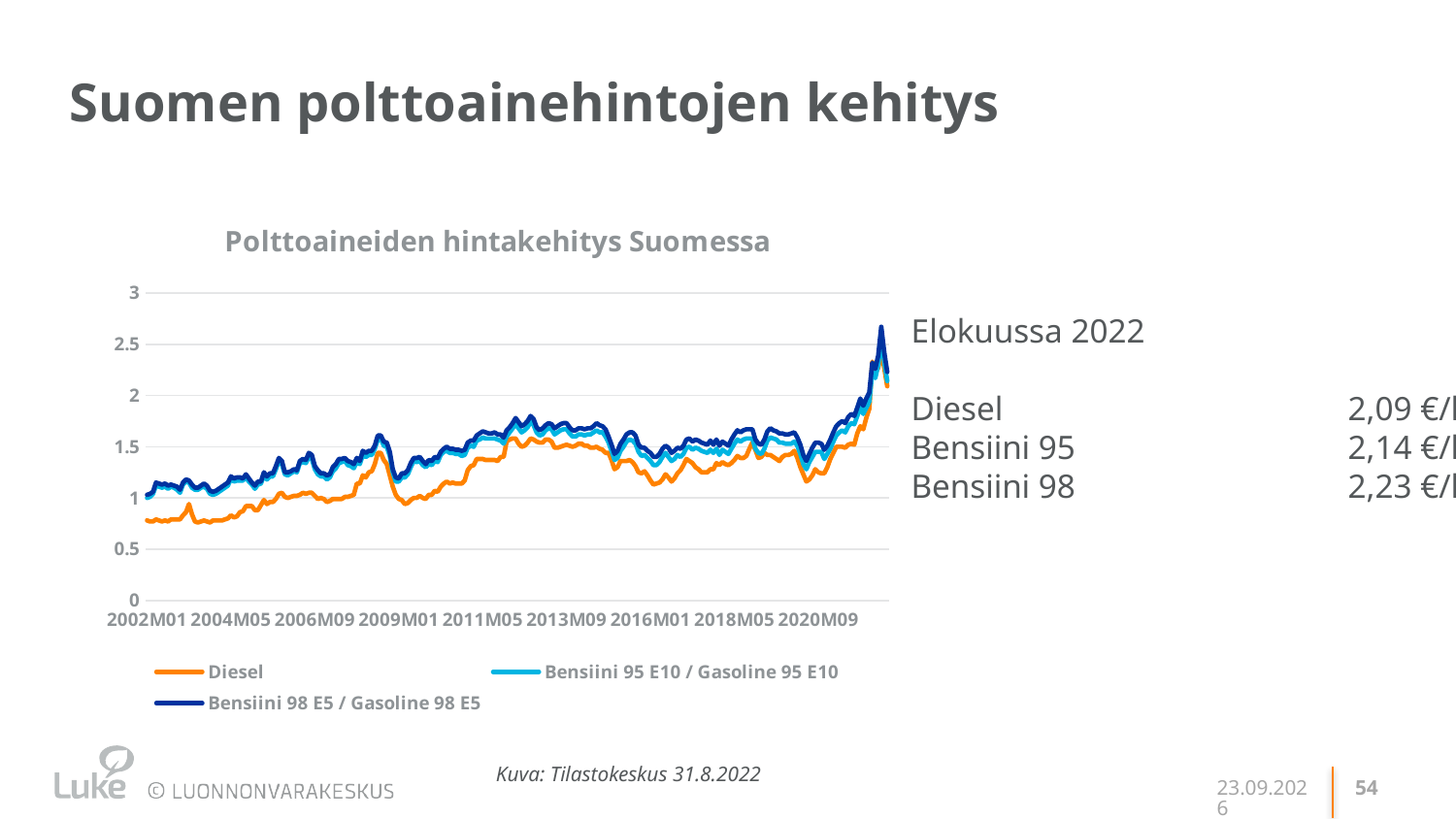
According to the slide, what was the Diesel price in August 2022 (Elokuussa 2022)? 2,09 €/l What is the title of the chart? Polttoaineiden hintakehitys Suomessa Which series reaches the highest value on the chart? Bensiini 98 E5 / Gasoline 98 E5 Overall, do fuel prices rise or fall from 2002M01 to the end of the series? rise Is the Diesel value at 2002M01 greater or less than 1? less In August 2022, which was higher: the Bensiini 95 price or the Diesel price? Bensiini 95 What is the difference between the Bensiini 98 and Diesel prices in August 2022 as given on the slide? 0,14 €/l According to the slide, what was the Bensiini 98 price in August 2022? 2,23 €/l What kind of chart is shown on the slide? line chart Is the peak value of Bensiini 98 E5 / Gasoline 98 E5 at the end of the series greater or less than 2.5? greater How many series does the chart's legend list? 3 Which series is the lowest across most of the chart? Diesel